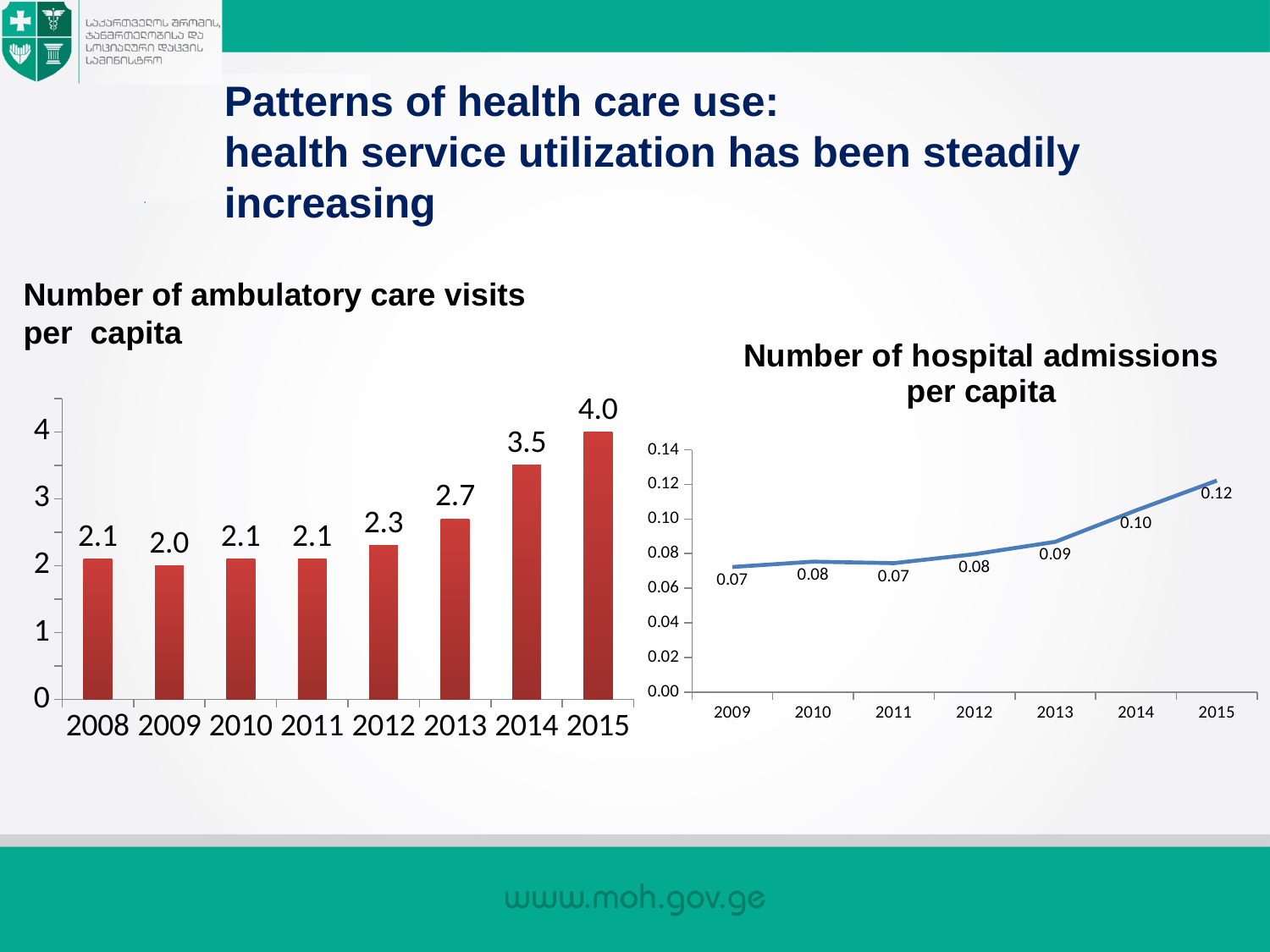
In the 'Number of hospital admissions per capita' chart, which year has the highest value? 2015 What kind of chart is the 'Number of hospital admissions per capita' chart? Line chart In the 'Number of hospital admissions per capita' chart, what is the difference between the 2015 and 2009 values? 0.05 In the 'Number of ambulatory care visits per capita' chart, which year has the lowest value? 2009 In the 'Number of ambulatory care visits per capita' chart, what is the value for 2015? 4.0 In the 'Number of ambulatory care visits per capita' chart, how many years are shown on the x axis? 8 In the 'Number of ambulatory care visits per capita' chart, what is the value for 2012? 2.3 In the 'Number of hospital admissions per capita' chart, how many years are shown on the x axis? 7 In the 'Number of ambulatory care visits per capita' chart, what is the difference between the 2015 and 2008 values? 1.9 What kind of chart is the 'Number of ambulatory care visits per capita' chart? Bar chart In the 'Number of hospital admissions per capita' chart, what is the value for 2013? 0.09 In the 'Number of hospital admissions per capita' chart, do the values generally rise or fall from 2009 to 2015? Rise